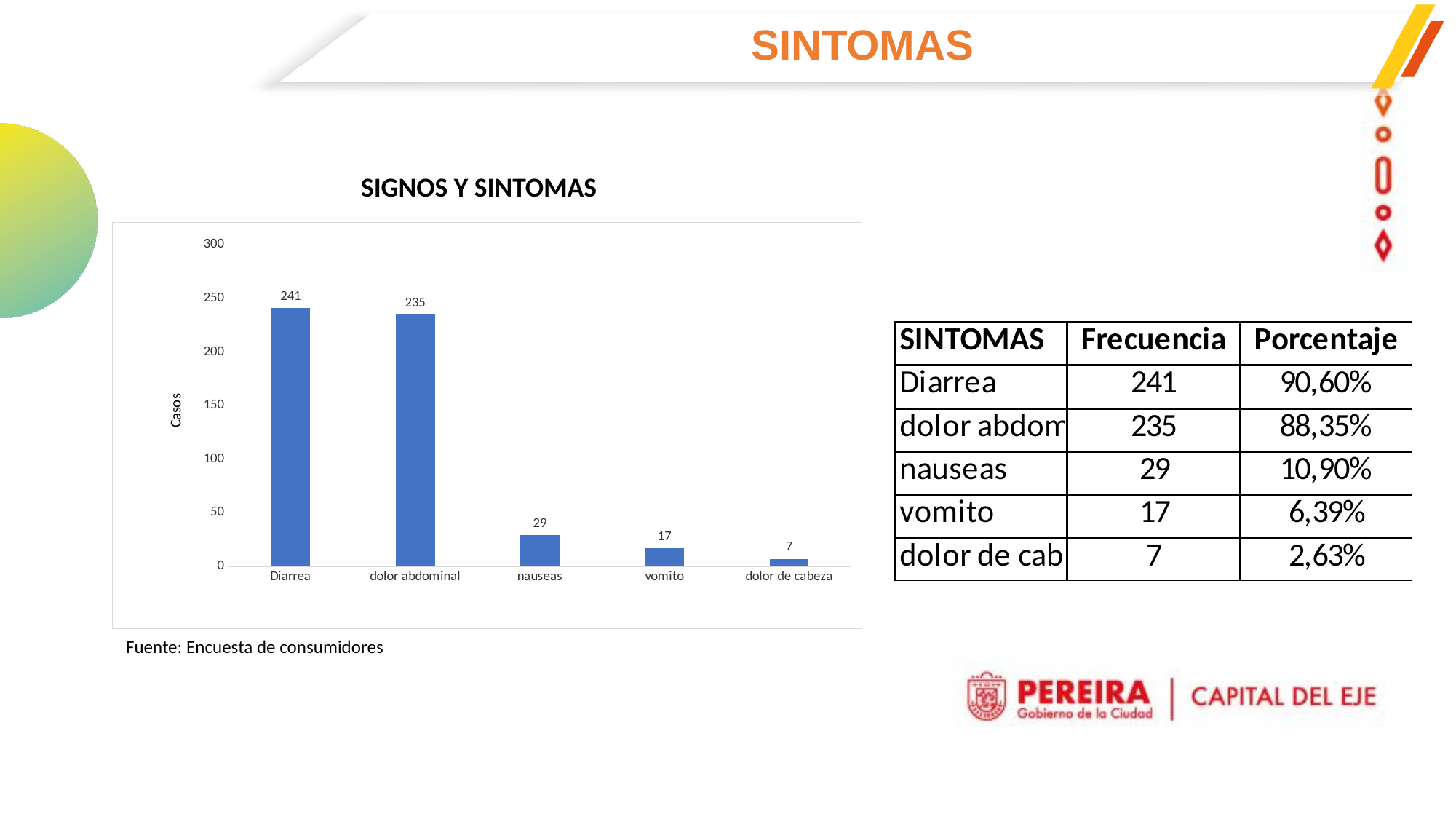
What is the difference between the values for nauseas and vomito in the SIGNOS Y SINTOMAS chart? 12 Which category has the lowest value in the SIGNOS Y SINTOMAS chart? dolor de cabeza How many categories are shown in the SIGNOS Y SINTOMAS chart? 5 What is the value for dolor abdominal in the SIGNOS Y SINTOMAS chart? 235 What is the value for Diarrea in the SIGNOS Y SINTOMAS chart? 241 What is the label of the vertical axis in the SIGNOS Y SINTOMAS chart? Casos Which category has the highest value in the SIGNOS Y SINTOMAS chart? Diarrea What is the difference between the values for Diarrea and dolor abdominal in the SIGNOS Y SINTOMAS chart? 6 What is the value for nauseas in the SIGNOS Y SINTOMAS chart? 29 What is the value for vomito in the SIGNOS Y SINTOMAS chart? 17 Which is larger in the SIGNOS Y SINTOMAS chart, nauseas or dolor de cabeza? nauseas What kind of chart is the SIGNOS Y SINTOMAS chart? bar chart